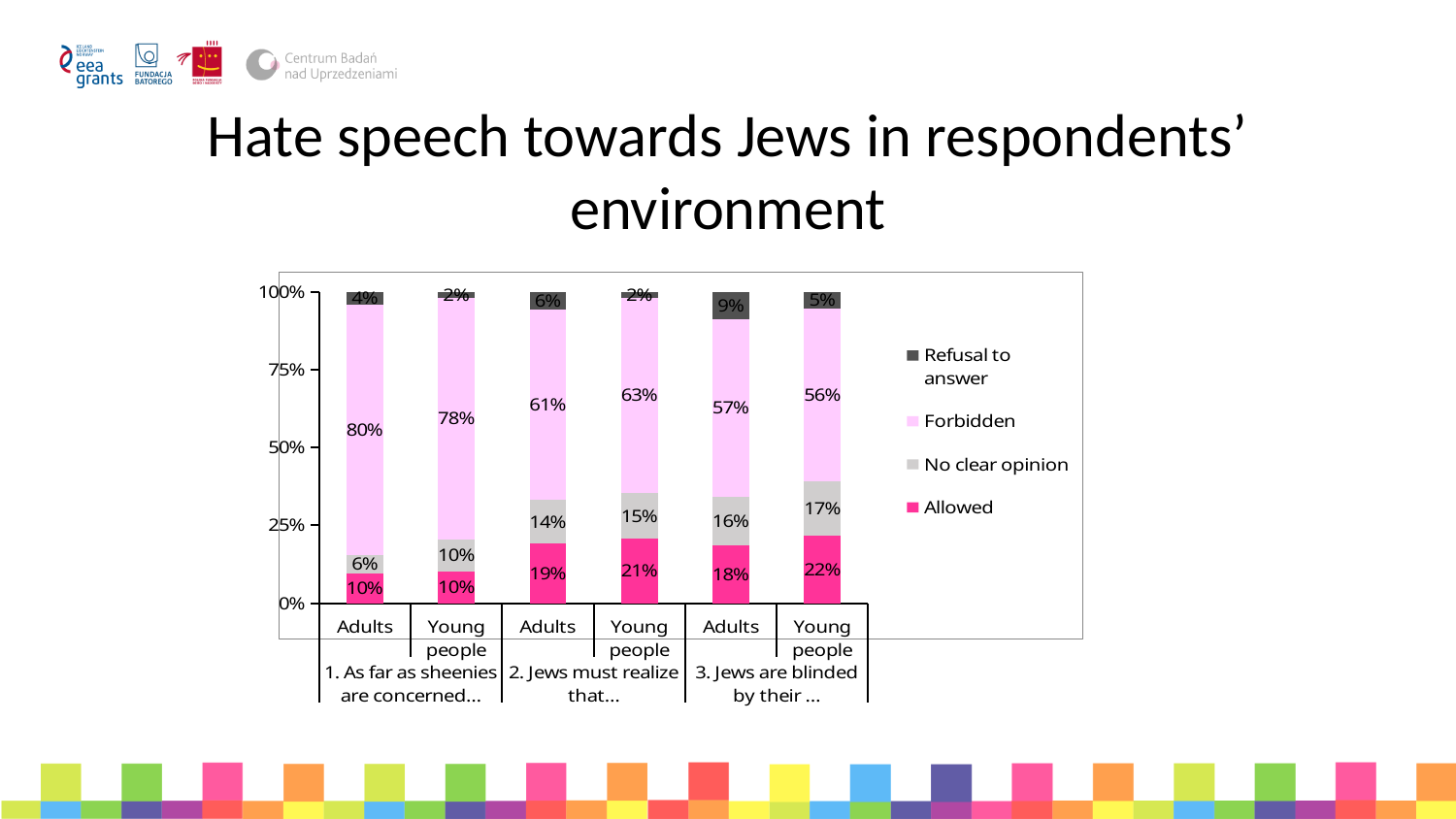
For statement 3 ("Jews are blinded by their ..."), is the "Allowed" share larger for adults or for young people? Young people What is the "Refusal to answer" share for adults on statement 3 ("Jews are blinded by their ...")? 9% What is the "No clear opinion" share for young people on statement 2 ("Jews must realize that...")? 15% What type of chart is shown on the slide? Stacked bar chart What percentage of young people said "Allowed" for statement 3 ("Jews are blinded by their ...")? 22% What is the difference between the "Forbidden" share for adults and for young people on statement 2 ("Jews must realize that...")? 2 percentage points How many series does the legend list? 4 Which bar has the lowest "Allowed" percentage? Adults and Young people for statement 1 (both 10%) How many bars are shown in the chart? 6 Which bar has the highest "Forbidden" percentage? Adults, statement 1 (As far as sheenies are concerned...) Which legend entry is shown in dark grey? Refusal to answer What percentage of adults said hate speech was "Forbidden" for statement 1 ("As far as sheenies are concerned...")? 80%